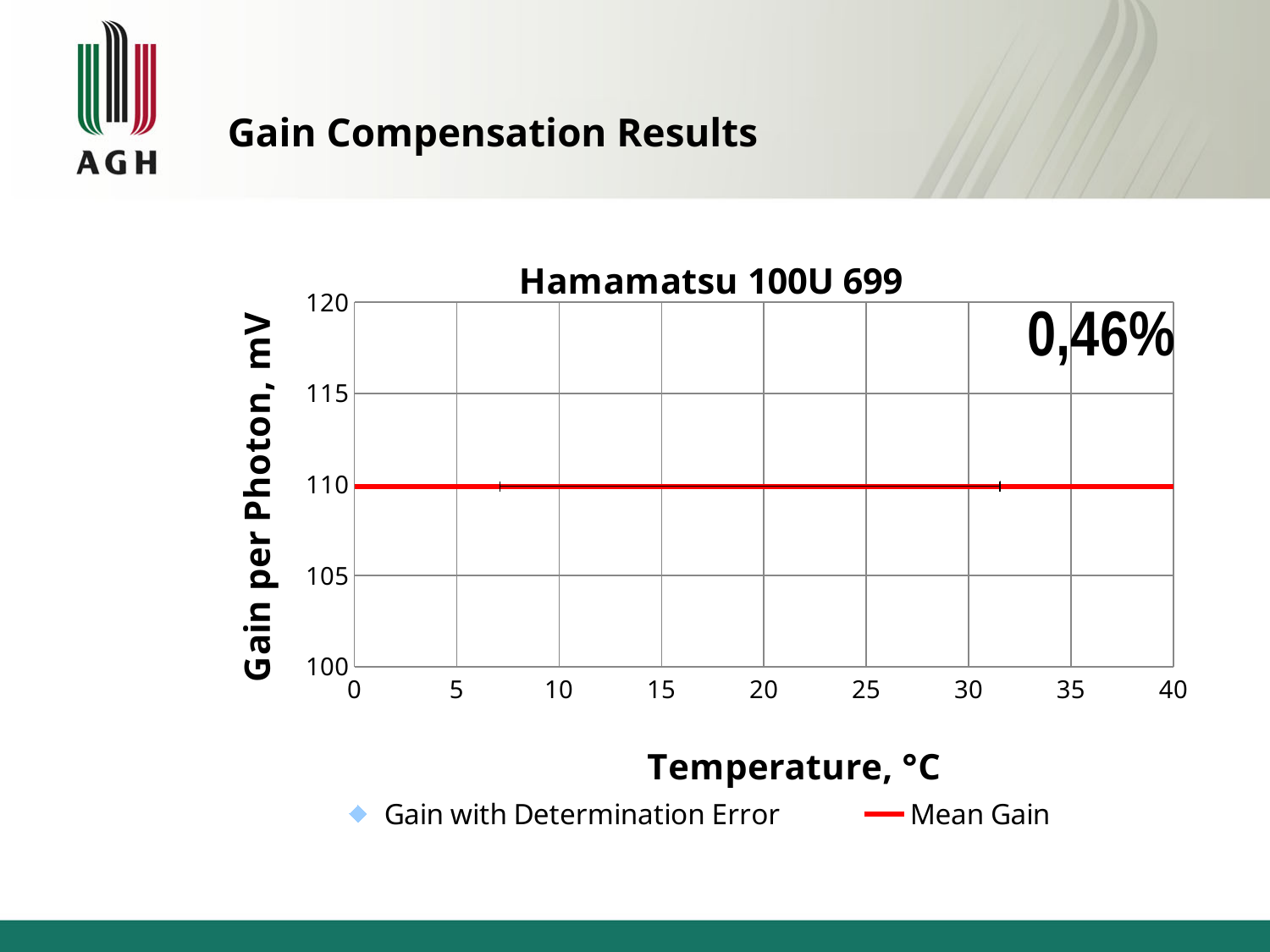
Does the Mean Gain rise, fall, or stay flat as temperature increases along the x axis? stays flat What kind of chart is shown on the slide? line chart What percentage is printed in the upper right corner of the chart? 0,46% What is the label of the y axis? Gain per Photon, mV What is the maximum value shown on the x axis (Temperature, °C)? 40 Is the Mean Gain value greater or less than 115? less How many series does the chart legend list? 2 Is the Mean Gain value greater or less than 105? greater What is the minimum value shown on the y axis? 100 What is the title of the chart? Hamamatsu 100U 699